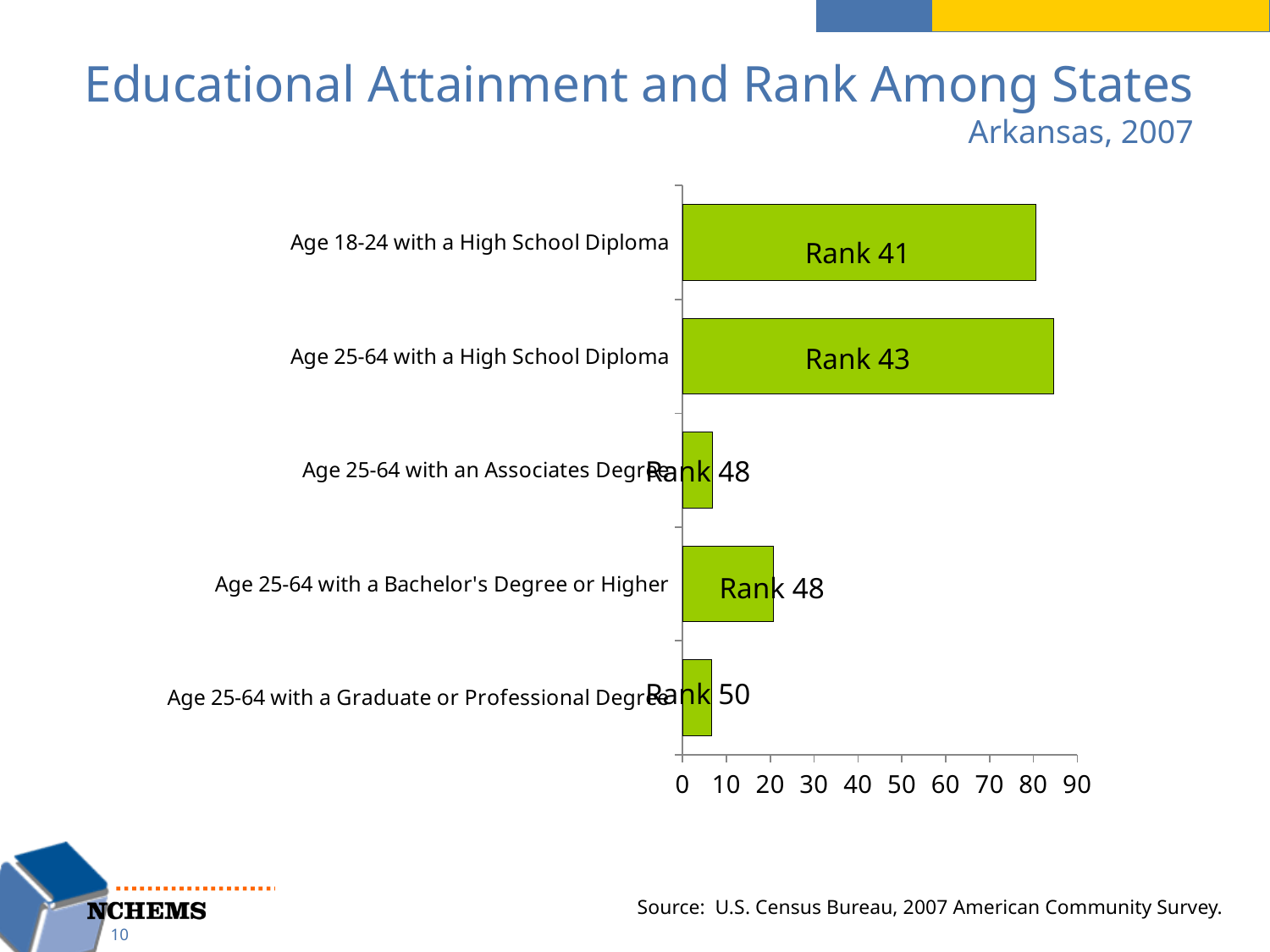
Is the value for Age 25-64 with a Bachelor's Degree or Higher greater or less than 30? less What rank is shown for Age 25-64 with a Graduate or Professional Degree? Rank 50 What kind of chart is shown on the slide? bar chart Is the value for Age 18-24 with a High School Diploma greater or less than 70? greater What rank is shown for Age 25-64 with a High School Diploma? Rank 43 What rank is shown for Age 25-64 with a Bachelor's Degree or Higher? Rank 48 Is the value for Age 25-64 with an Associates Degree greater or less than 10? less Which state and year does the chart cover, according to the subtitle? Arkansas, 2007 How many categories are plotted in the chart? 5 What rank is shown for Age 18-24 with a High School Diploma? Rank 41 Which category has the longest bar? Age 25-64 with a High School Diploma Which is larger, the value for Age 25-64 with a Bachelor's Degree or Higher or the value for Age 25-64 with an Associates Degree? Age 25-64 with a Bachelor's Degree or Higher